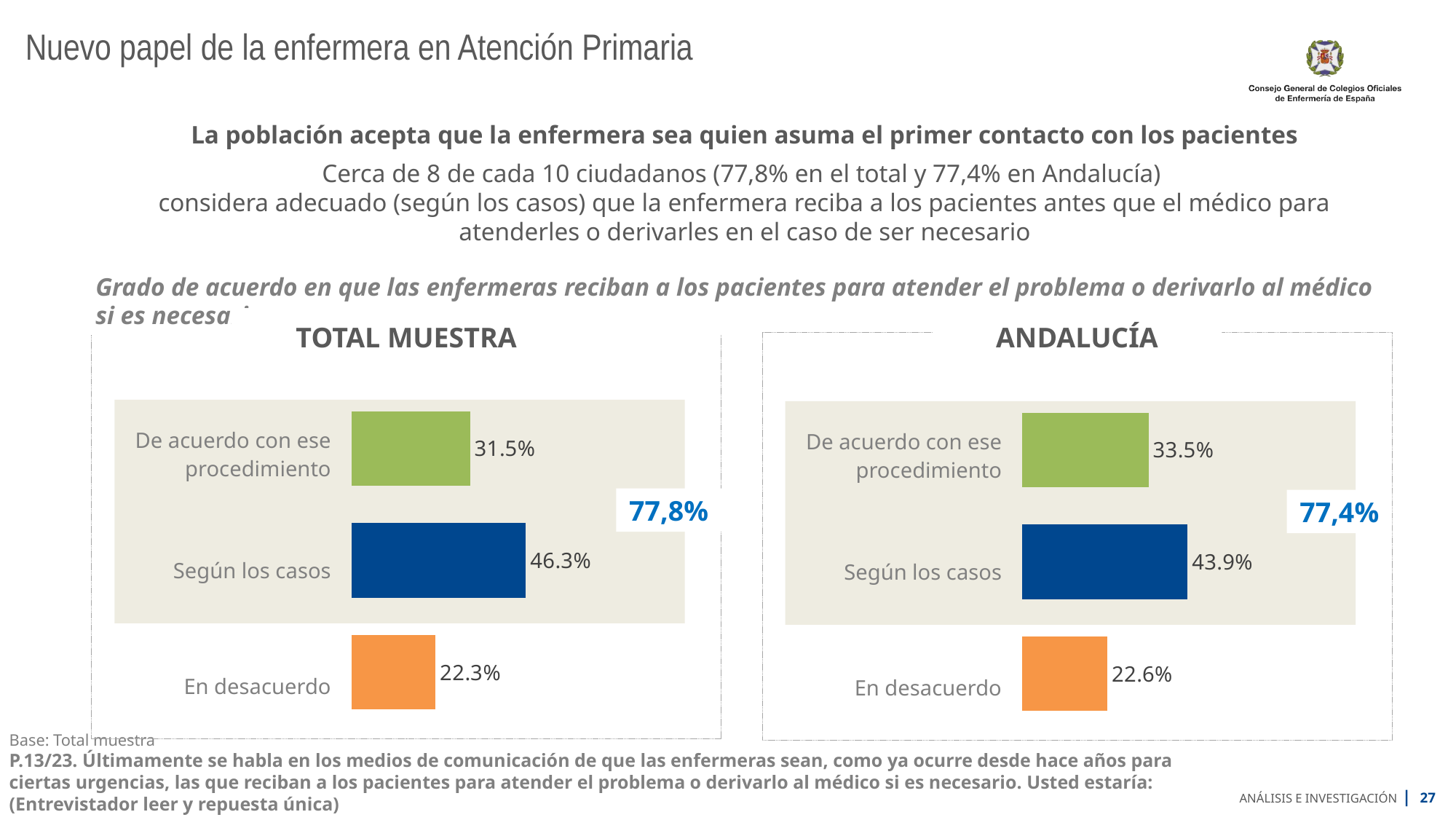
In the ANDALUCÍA chart, what is the difference between "Según los casos" and "En desacuerdo"? 21.3% Which is larger: "En desacuerdo" in the TOTAL MUESTRA chart or "En desacuerdo" in the ANDALUCÍA chart? ANDALUCÍA In the TOTAL MUESTRA chart, what is the value for "Según los casos"? 46.3% How many categories does the TOTAL MUESTRA chart show? 3 In the ANDALUCÍA chart, which category has the highest value? Según los casos In the TOTAL MUESTRA chart, what is the value for "En desacuerdo"? 22.3% In the TOTAL MUESTRA chart, what is the difference between "Según los casos" and "De acuerdo con ese procedimiento"? 14.8% In the TOTAL MUESTRA chart, which category has the lowest value? En desacuerdo In the ANDALUCÍA chart, what combined percentage is highlighted for the first two categories? 77,4% In the ANDALUCÍA chart, what is the value for "De acuerdo con ese procedimiento"? 33.5% In the TOTAL MUESTRA chart, what colour is the bar for "Según los casos"? Dark blue What kind of chart is the ANDALUCÍA chart? Bar chart